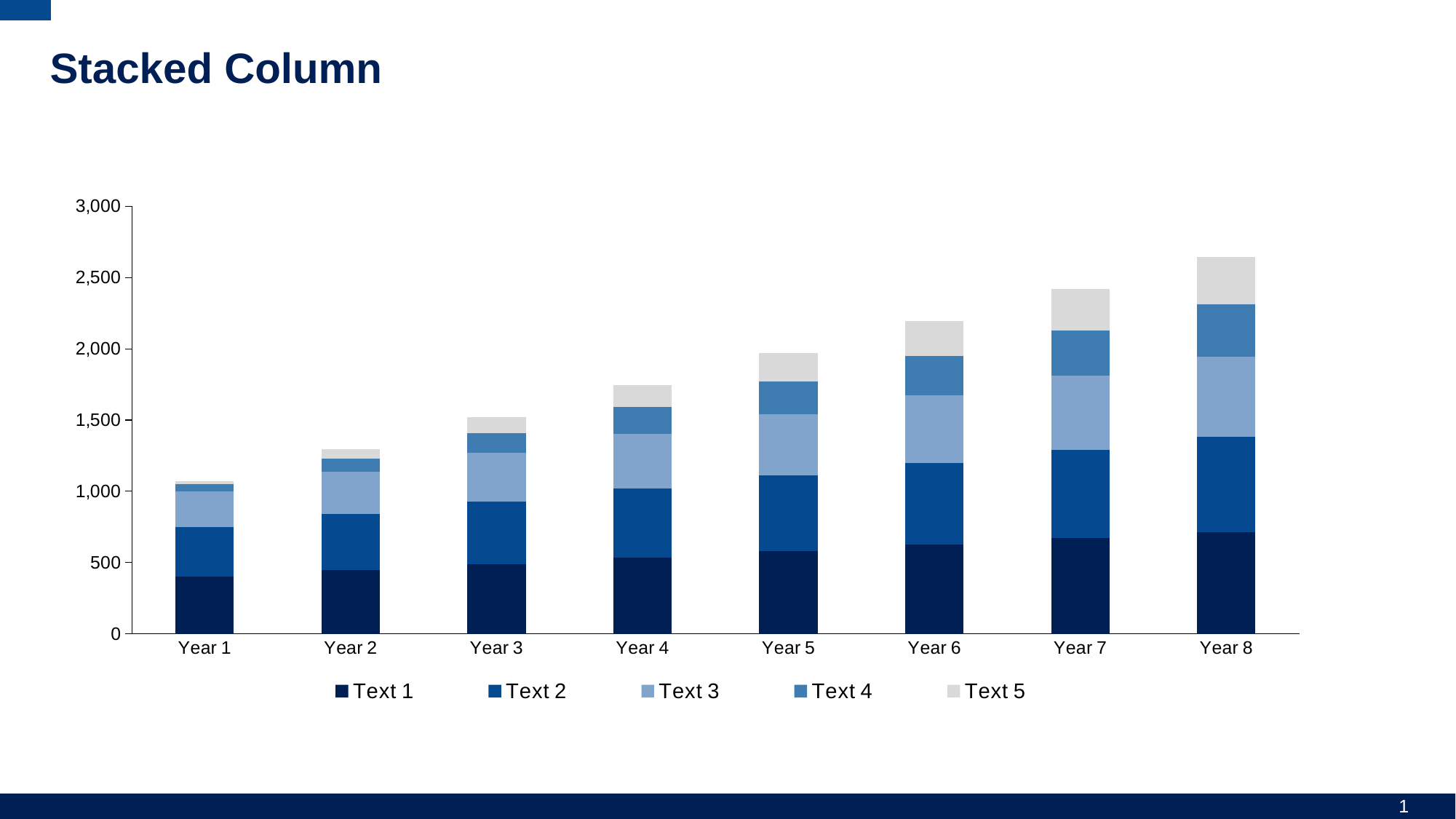
Is the total for Year 6 greater or less than 2,000? greater Which has the larger total bar, Year 3 or Year 7? Year 7 Which year has the highest total stacked bar? Year 8 Do the total bar heights rise or fall from Year 1 to Year 8? Rise Which year has the lowest total stacked bar? Year 1 Is the Text 1 value for Year 1 greater or less than 500? less Is the total for Year 2 greater or less than 1,500? less What is the title of the chart slide? Stacked Column How many series does the legend list? 5 How many categories are shown on the x axis? 8 What kind of chart is shown on the slide? Stacked bar chart